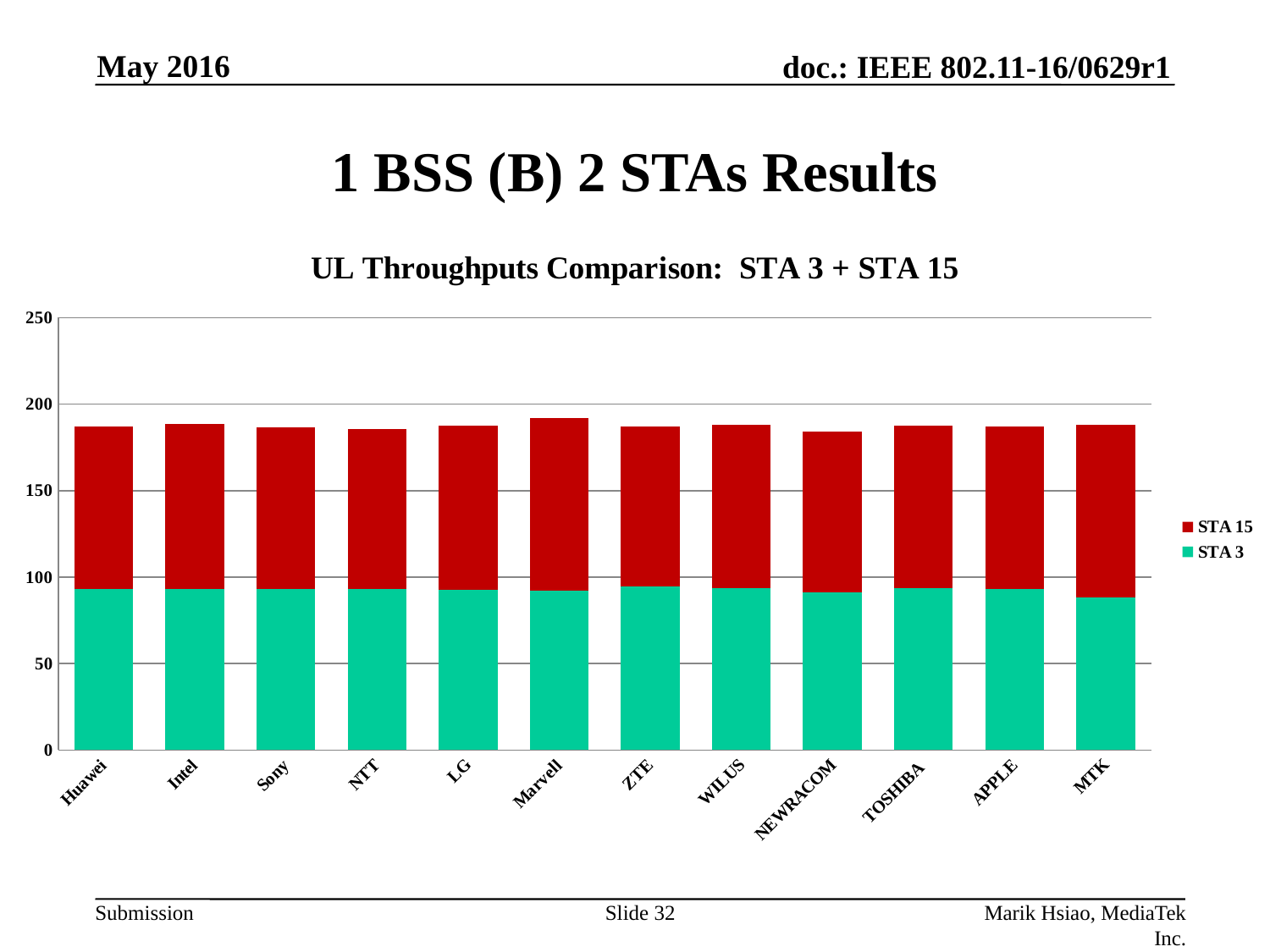
Which company has the lowest total stacked bar? NEWRACOM How many companies are shown along the x axis? 12 Is the STA 3 value for MTK greater or less than 50? greater Which company has the highest total stacked bar? Marvell Is the total stacked value for Huawei greater or less than 150? greater Is the STA 3 value for Huawei greater or less than 100? less What is the title of the chart? UL Throughputs Comparison: STA 3 + STA 15 How many series does the legend list? 2 Which company has the lowest STA 3 value? MTK What kind of chart is shown on the slide? stacked bar chart Which series is shown in red? STA 15